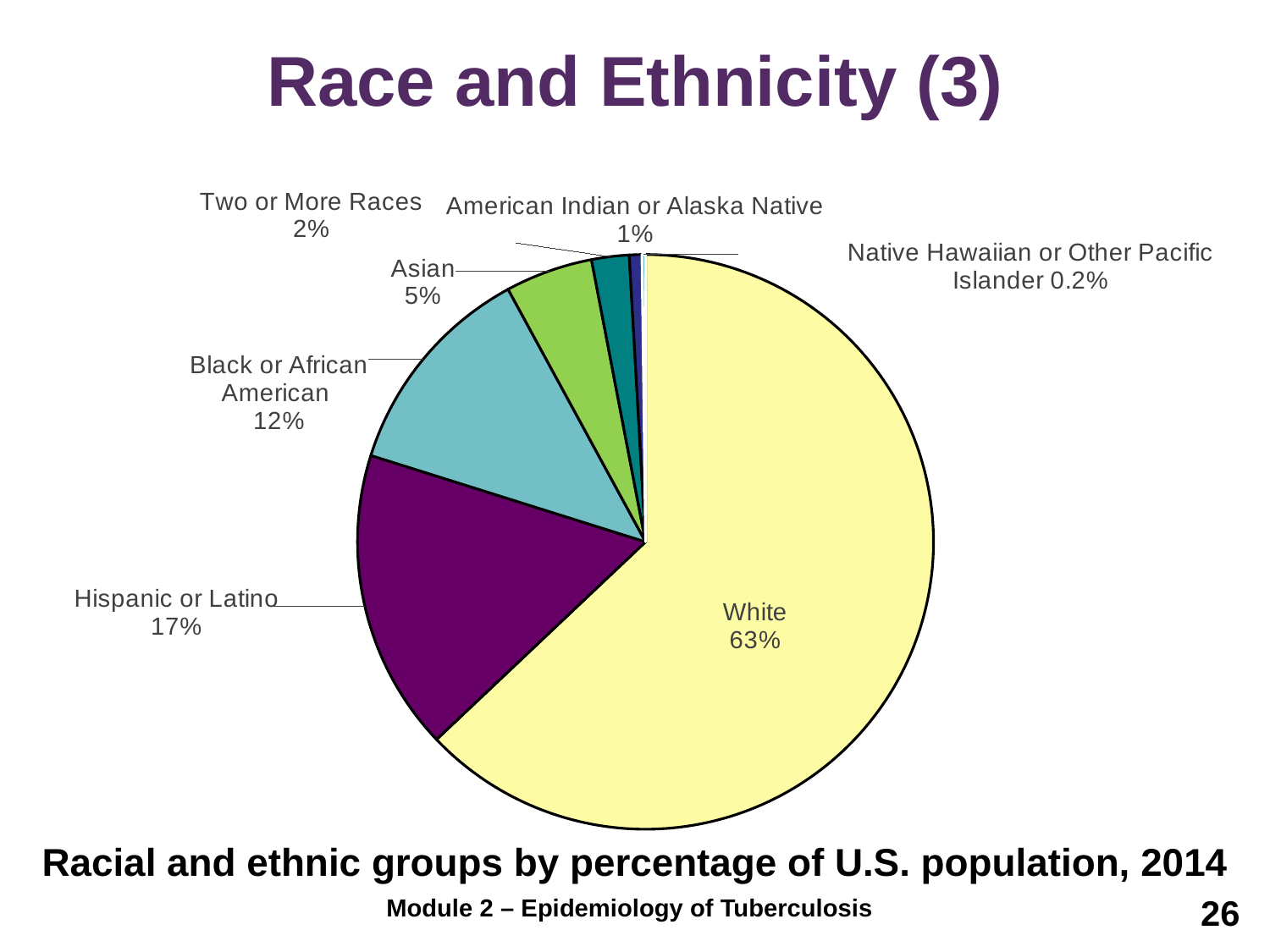
How many racial or ethnic groups are shown in the pie chart? 7 What percentage is shown for Black or African American? 12% What percentage of the U.S. population is White according to the chart? 63% Which racial or ethnic group has the smallest share of the pie? Native Hawaiian or Other Pacific Islander Which is larger, the share for Asian or the share for Two or More Races? Asian What kind of chart is shown on the slide? pie chart What percentage is shown for Hispanic or Latino? 17% What is the difference in percentage points between Hispanic or Latino and Black or African American? 5 What percentage is shown for Asian? 5% What is the caption below the pie chart? Racial and ethnic groups by percentage of U.S. population, 2014 Which racial or ethnic group has the largest share of the pie? White What percentage is shown for Native Hawaiian or Other Pacific Islander? 0.2%